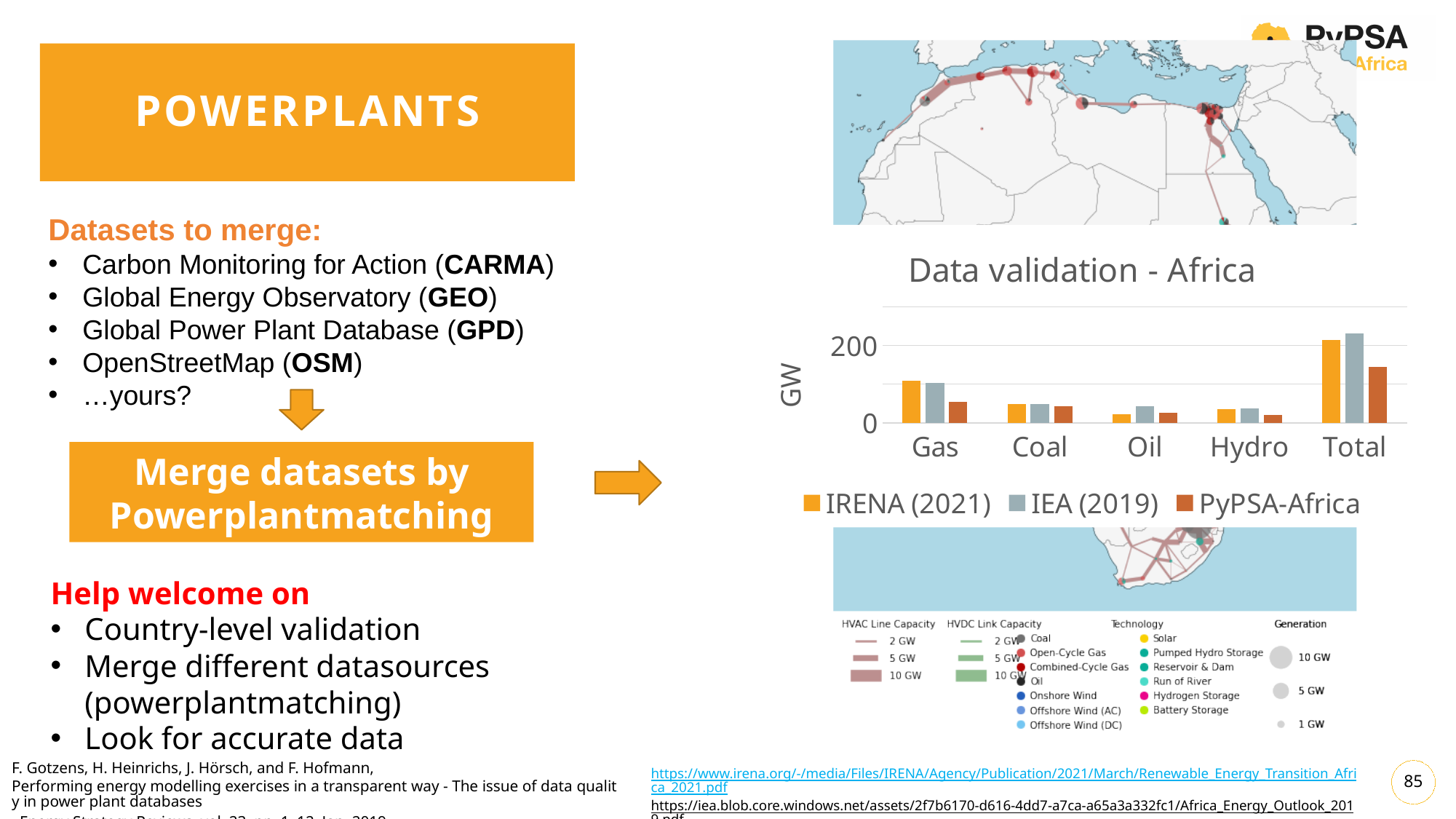
In the "Data validation - Africa" chart, is the IRENA (2021) value for Gas greater or less than 200? less What is the y-axis label of the "Data validation - Africa" chart? GW In the "Data validation - Africa" chart, is the IEA (2019) value for Total greater or less than 200? greater Which series in the "Data validation - Africa" chart is shown in grey? IEA (2019) How many categories are shown on the x axis of the "Data validation - Africa" chart? 5 In the "Data validation - Africa" chart, is the PyPSA-Africa value for Total greater or less than 200? less In the "Data validation - Africa" chart, which category has the lowest PyPSA-Africa value? Hydro What type of chart is shown under the title "Data validation - Africa"? bar chart In the "Data validation - Africa" chart, which is larger for Gas: the IRENA (2021) value or the PyPSA-Africa value? IRENA (2021) In the "Data validation - Africa" chart, which category has the highest IRENA (2021) value? Total How many series does the legend of the "Data validation - Africa" chart list? 3 In the "Data validation - Africa" chart, which is larger for Oil: the IEA (2019) value or the IRENA (2021) value? IEA (2019)